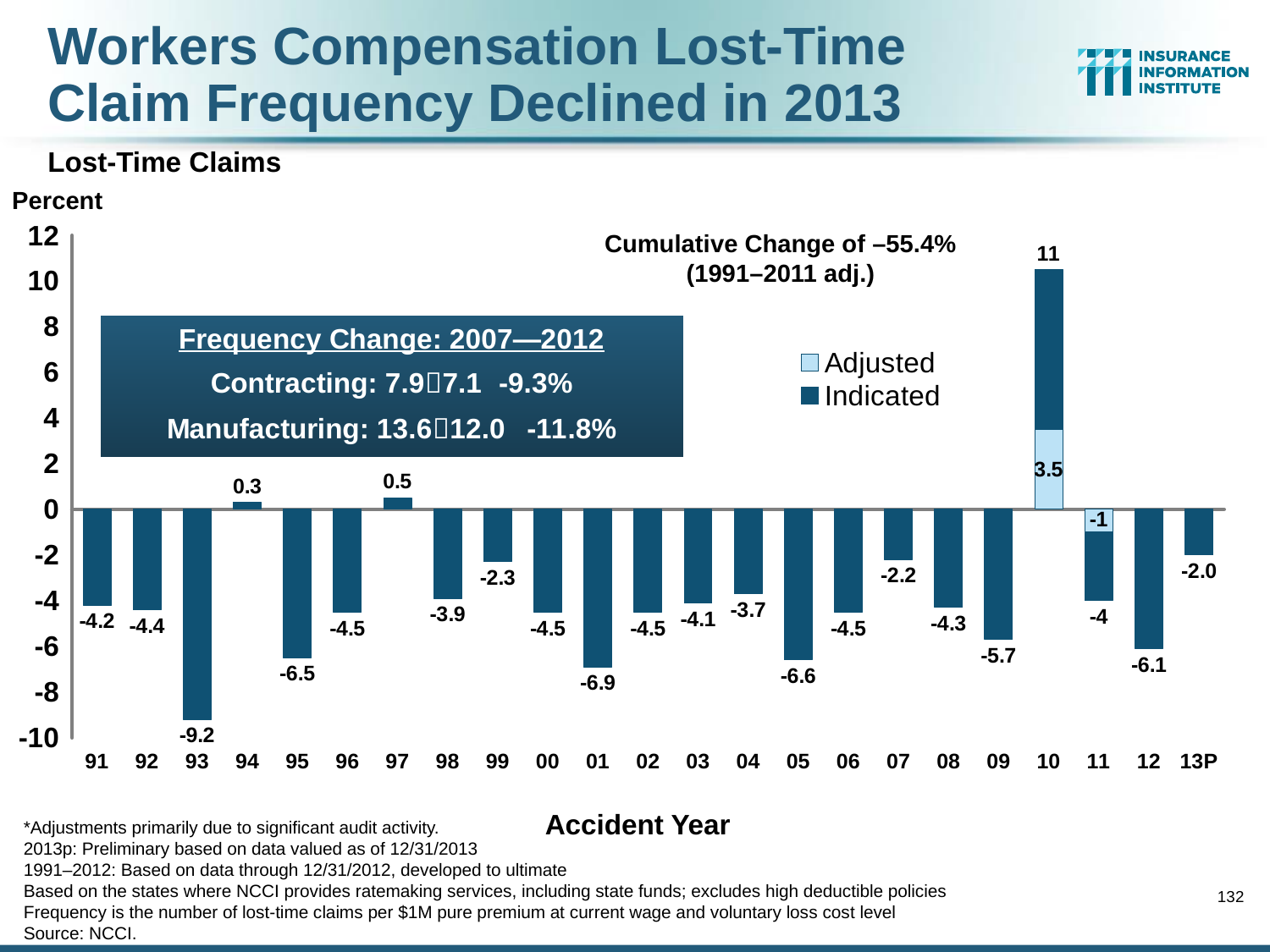
How many series does the legend list? 2 What is the difference between the values for accident years 93 and 01? 2.3 What is the Adjusted value for accident year 11? -1 What is the value for accident year 13P? -2.0 Which is larger, the value for accident year 94 or accident year 97? 97 What is the value for accident year 93? -9.2 What kind of chart is shown on the slide? Bar chart Which accident year has the lowest value? 93 What is the Indicated value for accident year 10? 11 How many accident years are shown on the x axis? 23 What cumulative change (1991–2011 adj.) is stated on the chart? –55.4% What is the Adjusted value for accident year 10? 3.5